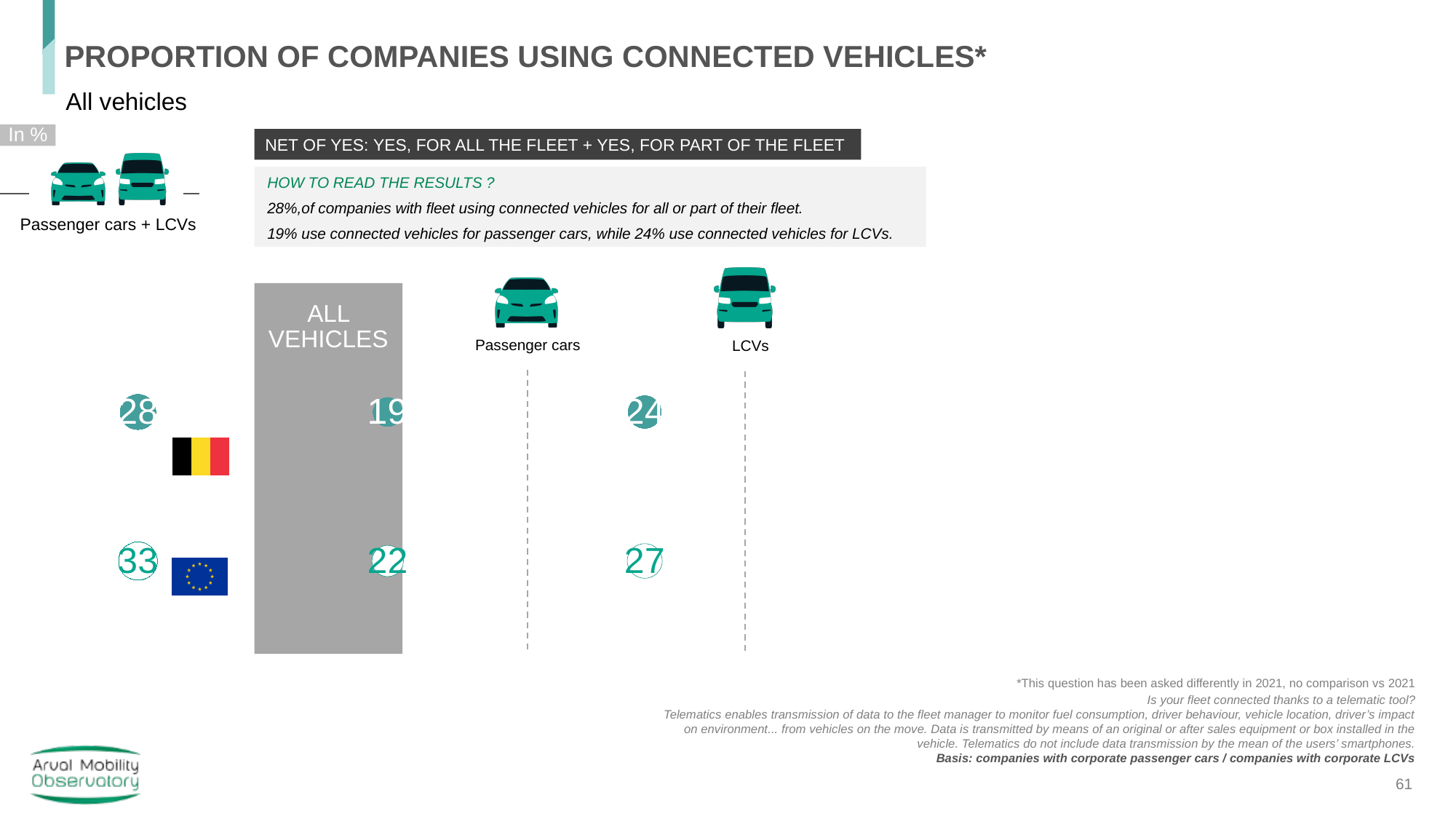
What is the value for LCVs in the row marked with the EU flag? 27 What is the value for passenger cars in the row marked with the Belgian flag? 19 How many vehicle categories are shown in the chart? 3 Which vehicle category has the lowest value in the row marked with the Belgian flag? Passenger cars What is the value for all vehicles in the row marked with the EU flag? 33 Which vehicle category has the highest value in the row marked with the EU flag? All vehicles What is the difference between the all-vehicles values for the EU flag row and the Belgian flag row? 5 What is the value for LCVs in the row marked with the Belgian flag? 24 What is the value for all vehicles in the row marked with the Belgian flag? 28 In what unit are the values in the chart expressed? % What is the value for passenger cars in the row marked with the EU flag? 22 Which is larger: the LCVs value in the Belgian flag row or the passenger cars value in the EU flag row? LCVs in the Belgian flag row